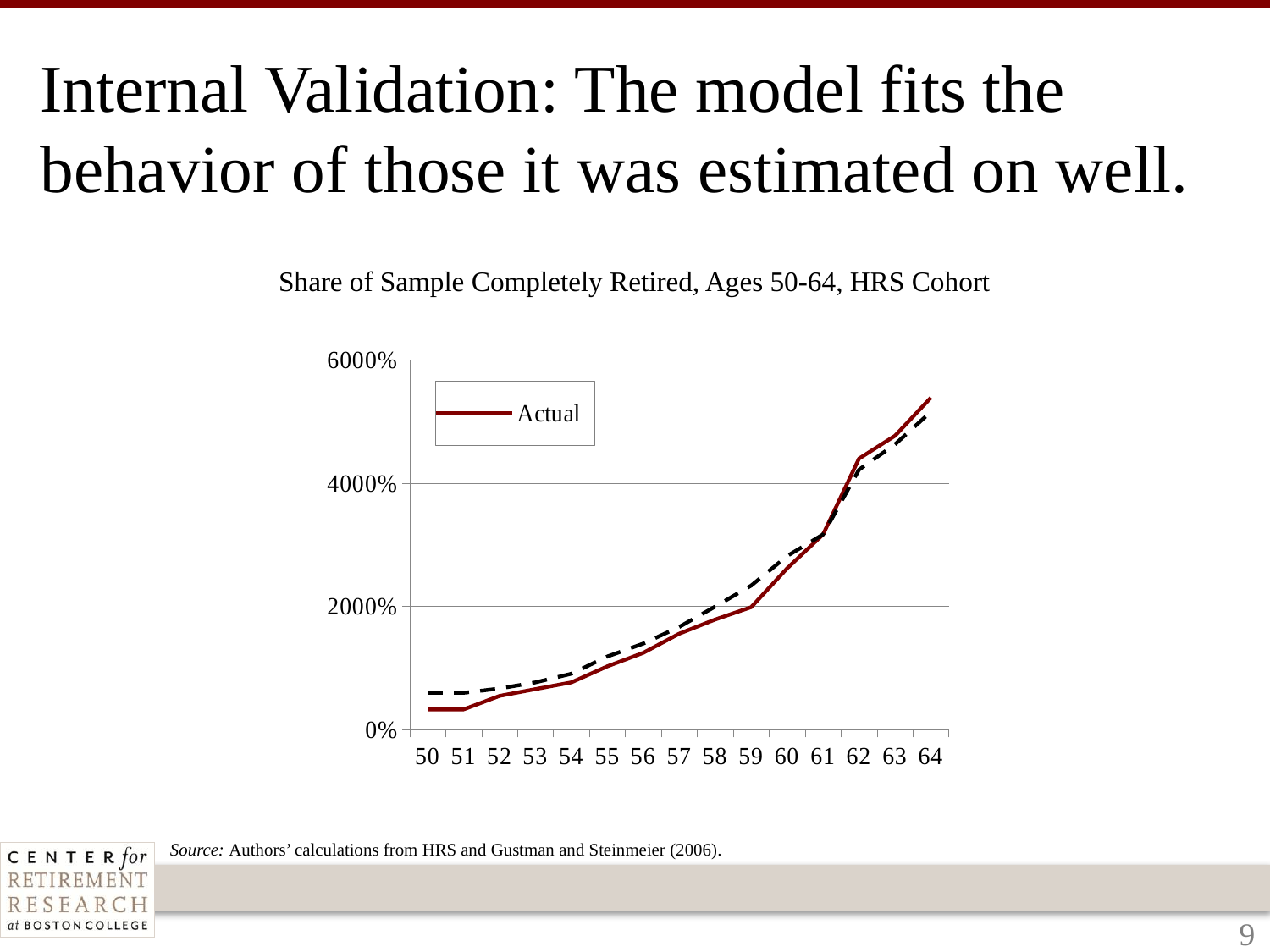
Is the Actual value at age 50 greater or less than 2000%? less Is the Actual value at age 64 greater or less than 4000%? greater Which is larger, the Actual value at age 64 or at age 50? age 64 How many series does the chart's legend list? 1 At which age is the Actual series highest? 64 What is the title of the chart? Share of Sample Completely Retired, Ages 50-64, HRS Cohort What kind of chart is shown on the slide? line chart Is the Actual value at age 61 greater or less than 4000%? less What is the name of the series shown in the chart's legend? Actual How many ages are plotted along the x axis of the chart? 15 Do the values of the Actual series rise or fall as age increases from 50 to 64? rise